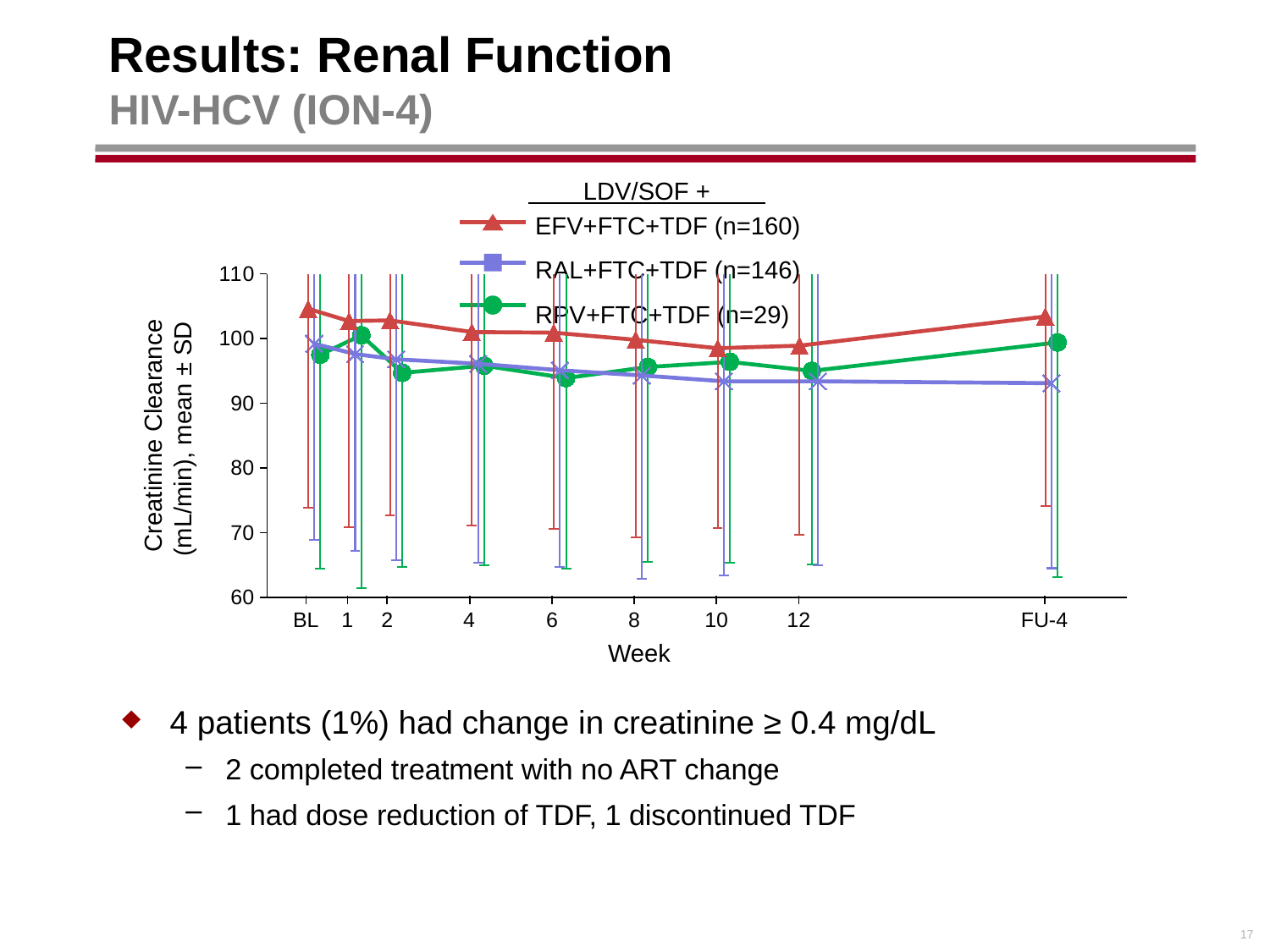
Is the creatinine clearance for EFV+FTC+TDF at BL greater or less than 100? greater Is the creatinine clearance for RPV+FTC+TDF at week 6 greater or less than 100? less How many time points are shown along the x axis (Week)? 9 What is the sample size (n) given in the legend for the RPV+FTC+TDF group? n=29 Is the creatinine clearance for RAL+FTC+TDF at FU-4 greater or less than 100? less At BL, which series has the higher creatinine clearance: EFV+FTC+TDF or RAL+FTC+TDF? EFV+FTC+TDF How many series does the legend list? 3 What kind of chart is shown on the slide? Line chart Which series has the highest creatinine clearance at FU-4? EFV+FTC+TDF Does the creatinine clearance for RAL+FTC+TDF rise or fall from BL to FU-4? Fall Which series has the lowest creatinine clearance at FU-4? RAL+FTC+TDF